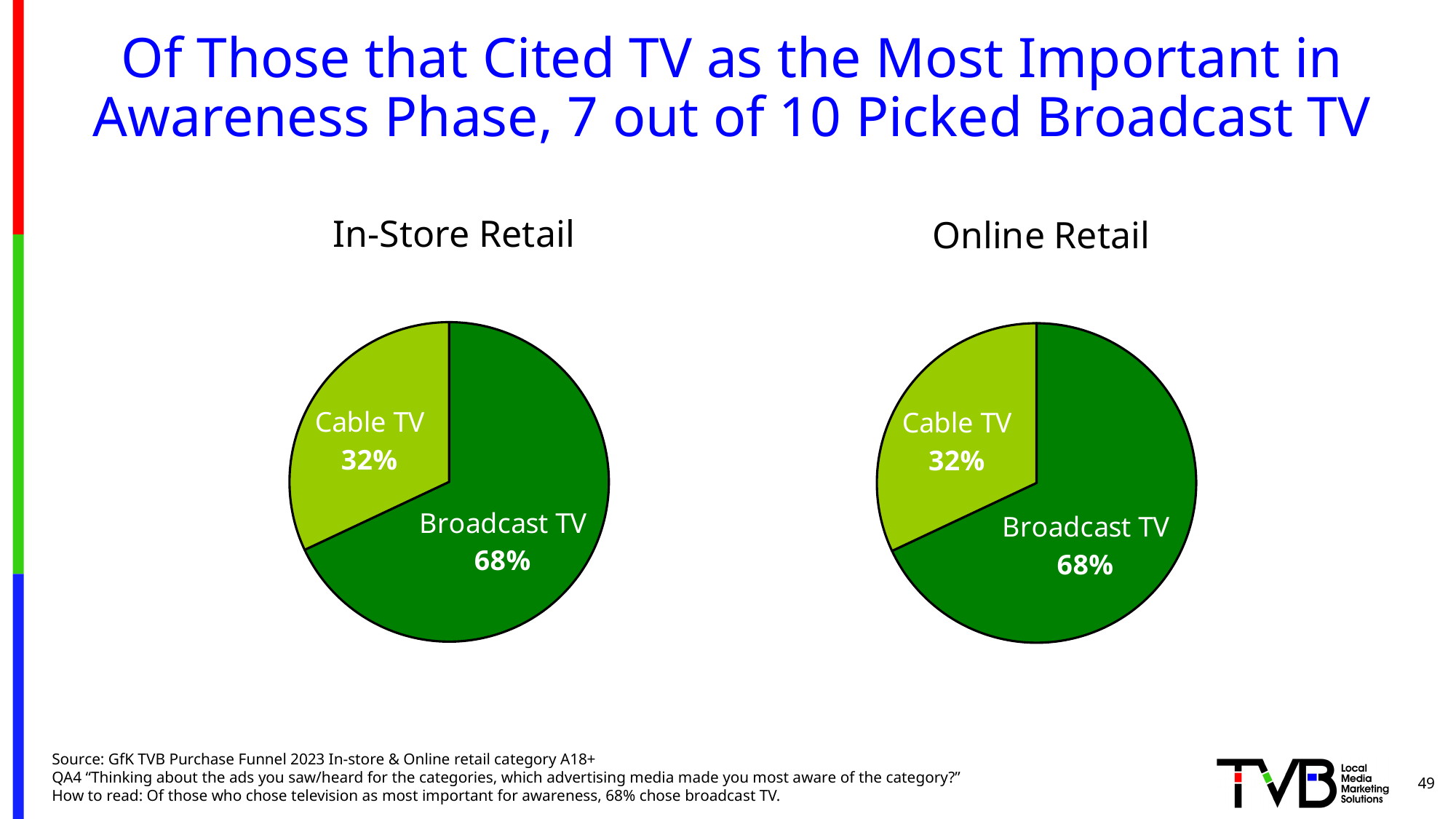
In the In-Store Retail chart, which slice is the largest? Broadcast TV How many slices does the In-Store Retail pie chart have? 2 In the Online Retail chart, which slice is the smallest? Cable TV What is the title of the chart on the left side of the slide? In-Store Retail In the In-Store Retail chart, what share is shown for Cable TV? 32% What type of chart is used for Online Retail? Pie chart In the Online Retail chart, what is the total of the Broadcast TV and Cable TV slices? 100% In the Online Retail chart, what share is shown for Cable TV? 32% In the In-Store Retail chart, what share is shown for Broadcast TV? 68% In the Online Retail chart, what share is shown for Broadcast TV? 68% In the Online Retail chart, which is larger, Broadcast TV or Cable TV? Broadcast TV In the In-Store Retail chart, what is the difference in percentage points between Broadcast TV and Cable TV? 36 percentage points